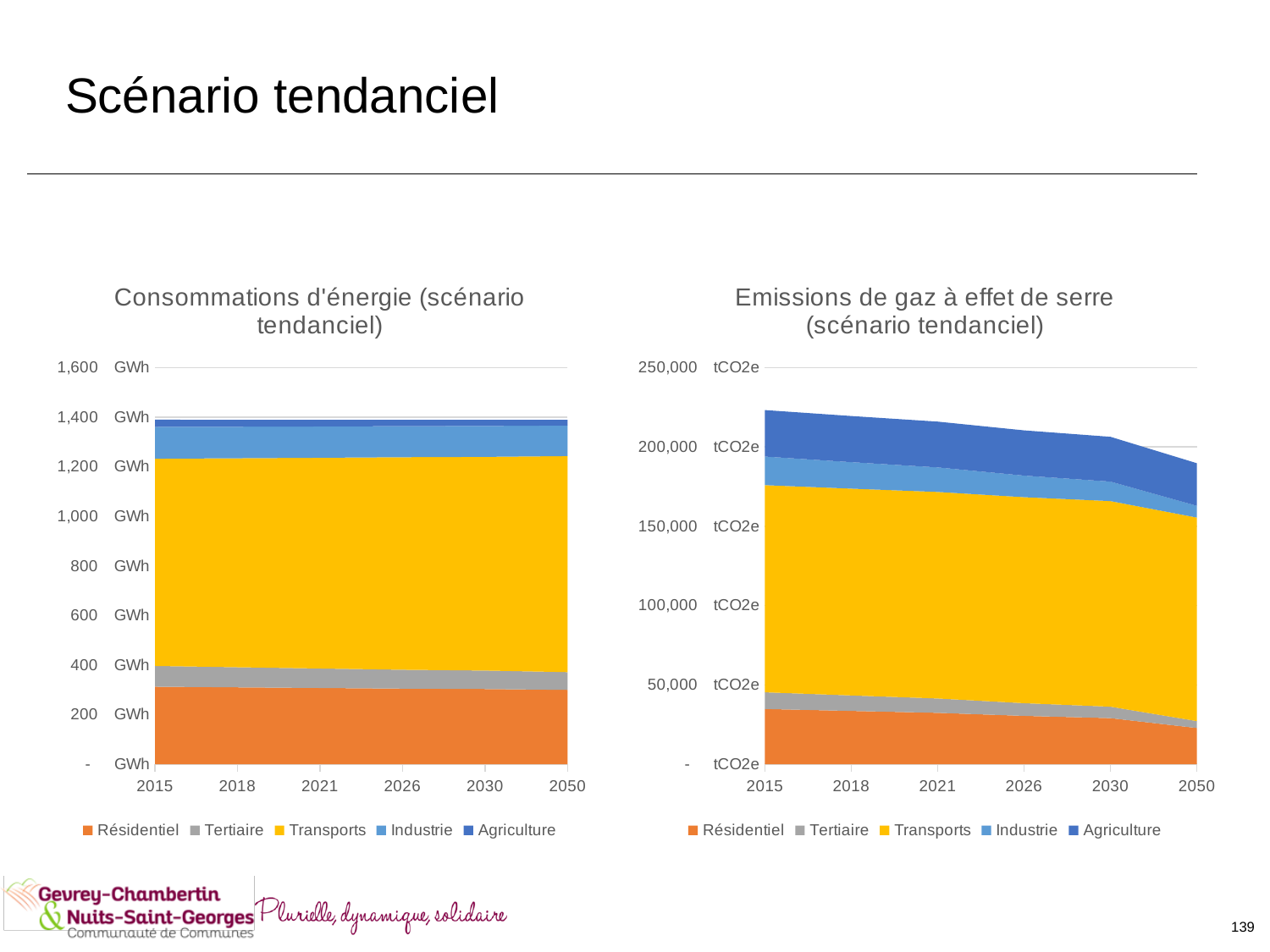
In the 'Emissions de gaz à effet de serre (scénario tendanciel)' chart, which is larger in 2015, Agriculture or Industrie? Agriculture What type of chart is the 'Consommations d'énergie (scénario tendanciel)' chart? stacked area chart What unit is shown on the y axis of the 'Emissions de gaz à effet de serre (scénario tendanciel)' chart? tCO2e In the 'Emissions de gaz à effet de serre (scénario tendanciel)' chart, which sector accounts for the largest share of emissions? Transports In the 'Consommations d'énergie (scénario tendanciel)' chart, is the total for 2015 greater or less than 1,200 GWh? greater How many years are shown on the x axis of the 'Consommations d'énergie (scénario tendanciel)' chart? 6 In the 'Emissions de gaz à effet de serre (scénario tendanciel)' chart, is the total for 2015 greater or less than 200,000 tCO2e? greater In the 'Consommations d'énergie (scénario tendanciel)' chart, which sector has the smallest share of consumption? Agriculture In the 'Emissions de gaz à effet de serre (scénario tendanciel)' chart, do total emissions rise or fall from 2015 to 2050? fall In the 'Emissions de gaz à effet de serre (scénario tendanciel)' chart, is the total for 2050 greater or less than 200,000 tCO2e? less In the 'Consommations d'énergie (scénario tendanciel)' chart, which sector accounts for the largest share of consumption? Transports How many series does the legend of the 'Emissions de gaz à effet de serre (scénario tendanciel)' chart list? 5